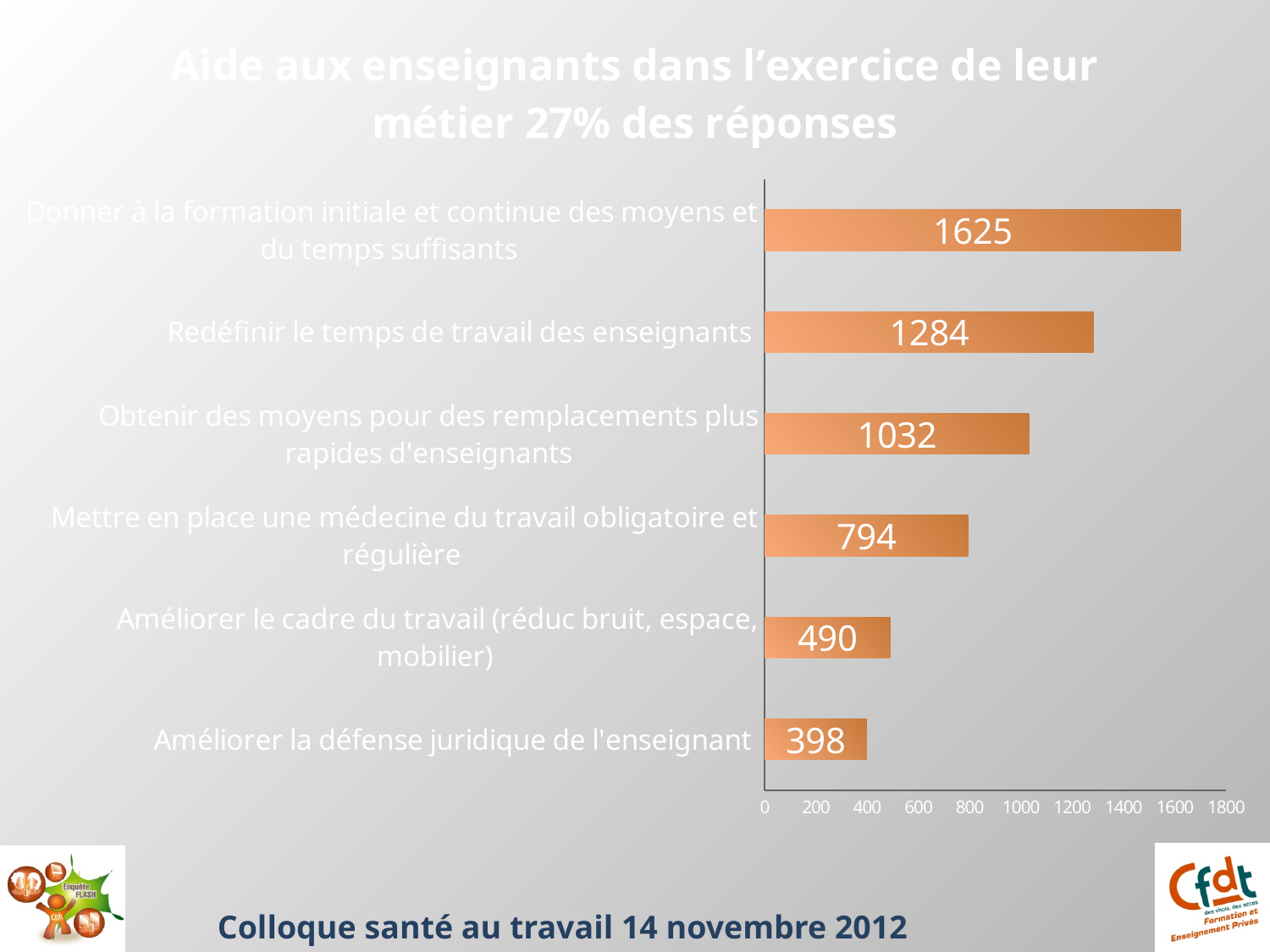
What is the value for "Améliorer la défense juridique de l'enseignant"? 398 What is the difference between the values for "Améliorer le cadre du travail (réduc bruit, espace, mobilier)" and "Améliorer la défense juridique de l'enseignant"? 92 What is the difference between the values for "Donner à la formation initiale et continue des moyens et du temps suffisants" and "Redéfinir le temps de travail des enseignants"? 341 Is the value for "Améliorer le cadre du travail (réduc bruit, espace, mobilier)" greater or less than 600? less Which category has the lowest value? Améliorer la défense juridique de l'enseignant Which category has the highest value? Donner à la formation initiale et continue des moyens et du temps suffisants What kind of chart is shown on the slide? Bar chart What is the title of the chart? Aide aux enseignants dans l'exercice de leur métier 27% des réponses How many categories are shown in the chart? 6 What is the value for "Redéfinir le temps de travail des enseignants"? 1284 Which is larger: the value for "Obtenir des moyens pour des remplacements plus rapides d'enseignants" or the value for "Mettre en place une médecine du travail obligatoire et régulière"? Obtenir des moyens pour des remplacements plus rapides d'enseignants What is the value for "Mettre en place une médecine du travail obligatoire et régulière"? 794